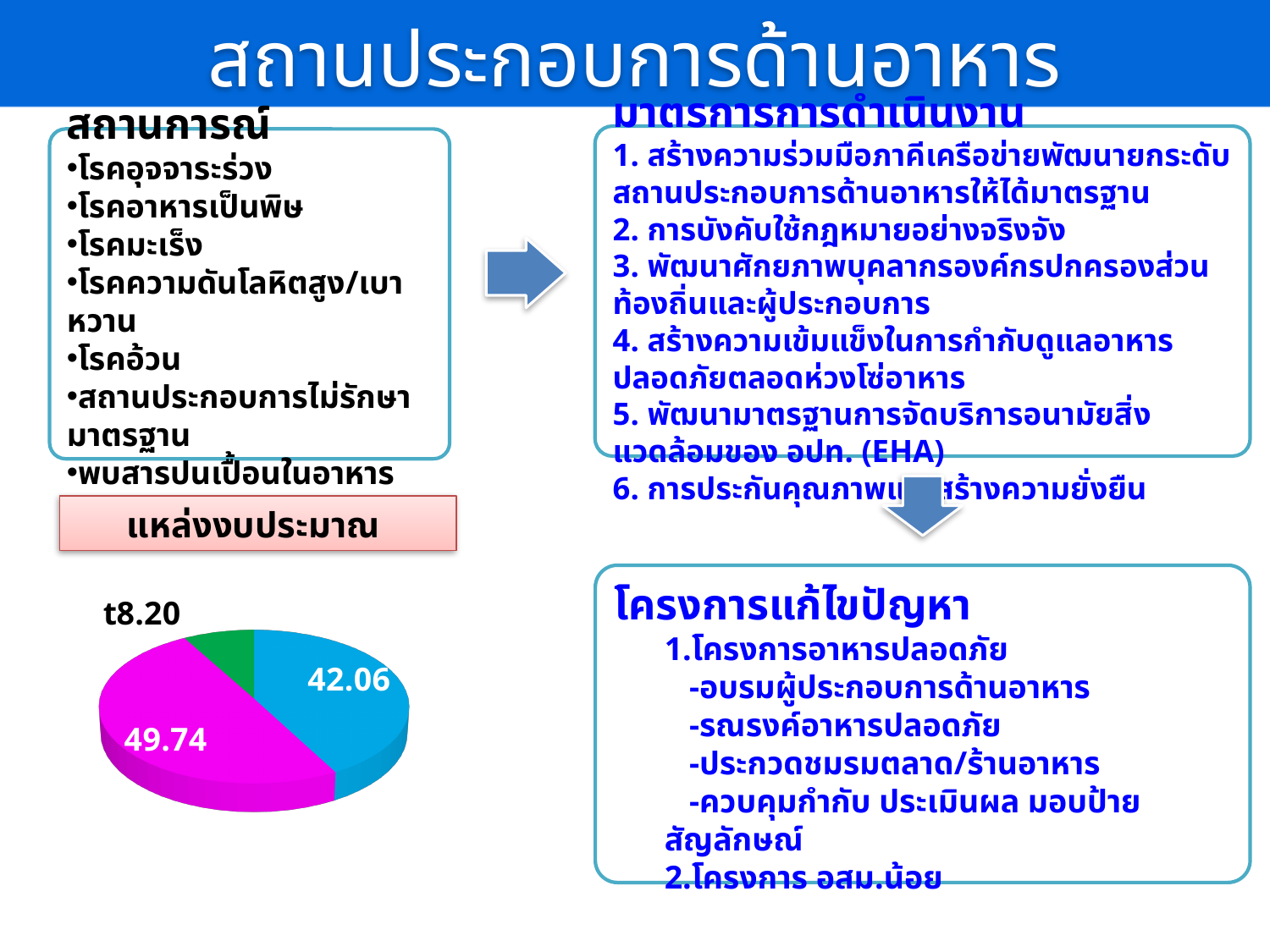
What heading appears in the pink box directly above the pie chart? แหล่งงบประมาณ What kind of chart is shown on the slide? pie chart What colours are the three slices of the pie chart? blue, magenta and green Which is larger in the pie chart, the magenta slice or the blue slice? the magenta slice Which slice of the pie chart is the smallest? the green slice How many slices does the pie chart have? 3 What value is printed on the magenta slice of the pie chart? 49.74 What value is printed on the blue slice of the pie chart? 42.06 Which slice of the pie chart is the largest? the magenta slice (49.74) What is the difference between the magenta slice value and the blue slice value in the pie chart? 7.68